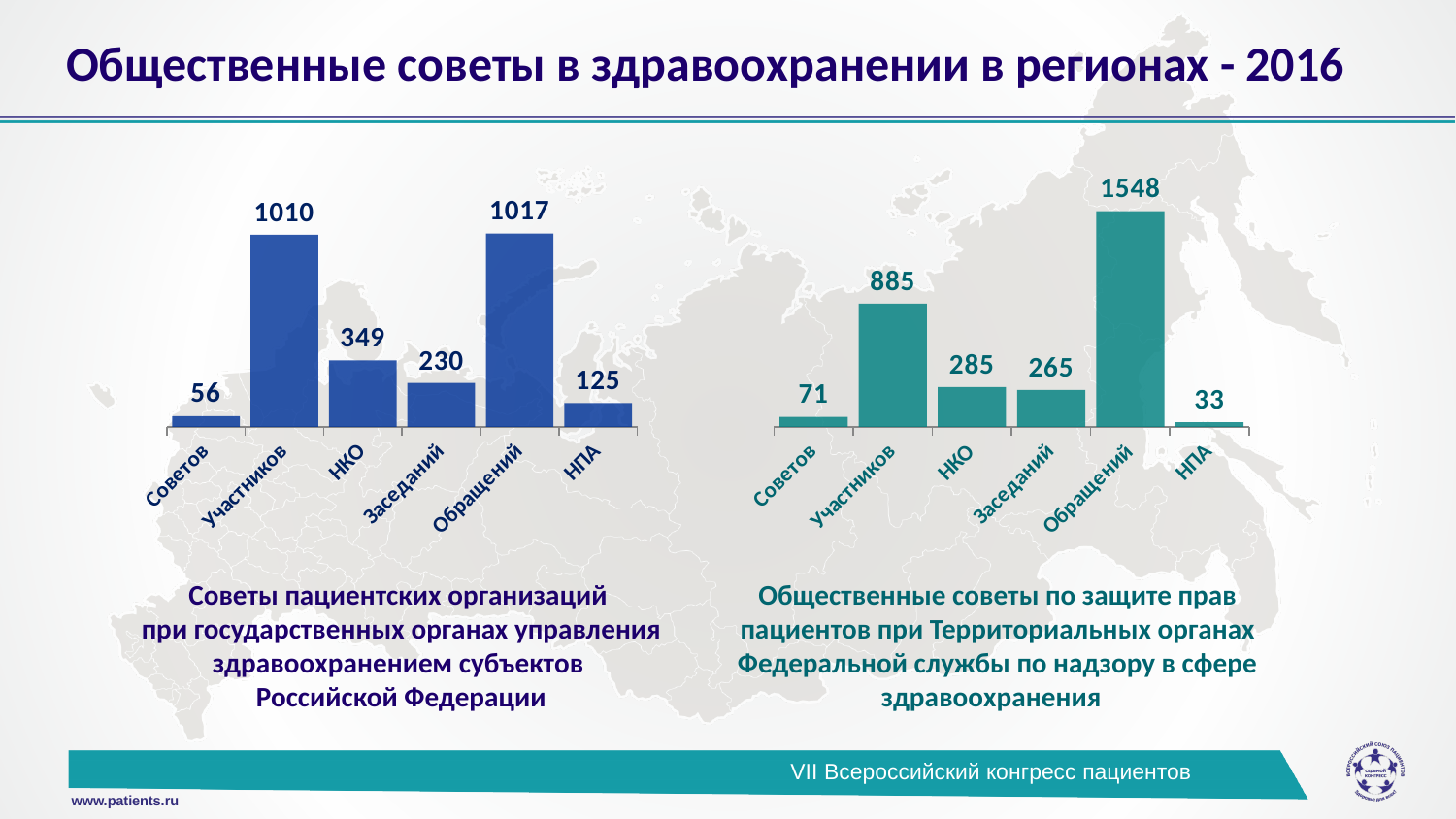
In the left chart, what is the value for НПА? 125 In the right chart (Общественные советы по защите прав пациентов), what is the value for Обращений? 1548 In the right chart, which category has the lowest value? НПА In the right chart, what is the value for Советов? 71 In the right chart, what is the difference between the values for Участников and НКО? 600 In the left chart, which category has the lowest value? Советов Which is larger: the value for Заседаний in the left chart or the value for Заседаний in the right chart? Right chart (265) In the left chart (Советы пациентских организаций), what is the value for Участников? 1010 In the left chart, what is the difference between the values for НКО and Заседаний? 119 What type of chart is used on the slide? Bar chart In the right chart, which category has the highest value? Обращений How many categories does the left chart show? 6